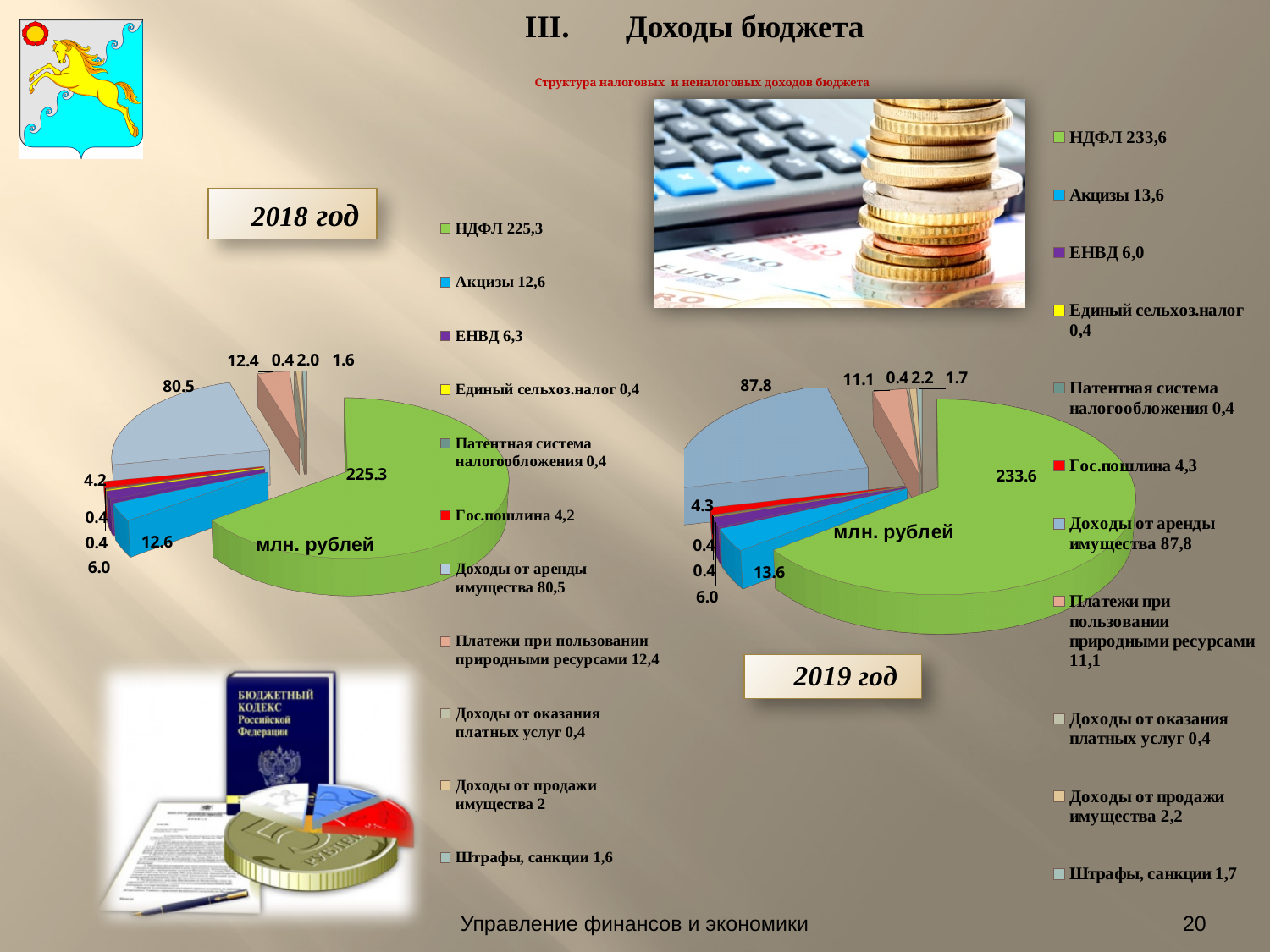
How many categories does the legend of the 2019 год chart on the right list? 11 In the 2019 год chart on the right, what is the difference between Доходы от аренды имущества and Платежи при пользовании природными ресурсами? 76.7 In the 2018 год chart on the left, what is the value for Доходы от аренды имущества? 80.5 In the 2018 год chart on the left, which is larger: Акцизы or Платежи при пользовании природными ресурсами? Акцизы What unit label is printed inside both pie charts? млн. рублей In the 2019 год chart on the right, what is the value for Гос.пошлина? 4.3 In the 2018 год chart on the left, what is the value for НДФЛ? 225.3 In the 2019 год chart on the right, what is the value for НДФЛ? 233.6 In the 2019 год chart on the right, which category has the largest slice? НДФЛ In the 2019 год chart on the right, what is the value for Акцизы? 13.6 What type of chart is used for the 2018 год chart on the left? pie chart In the 2018 год chart on the left, which category has the largest slice? НДФЛ